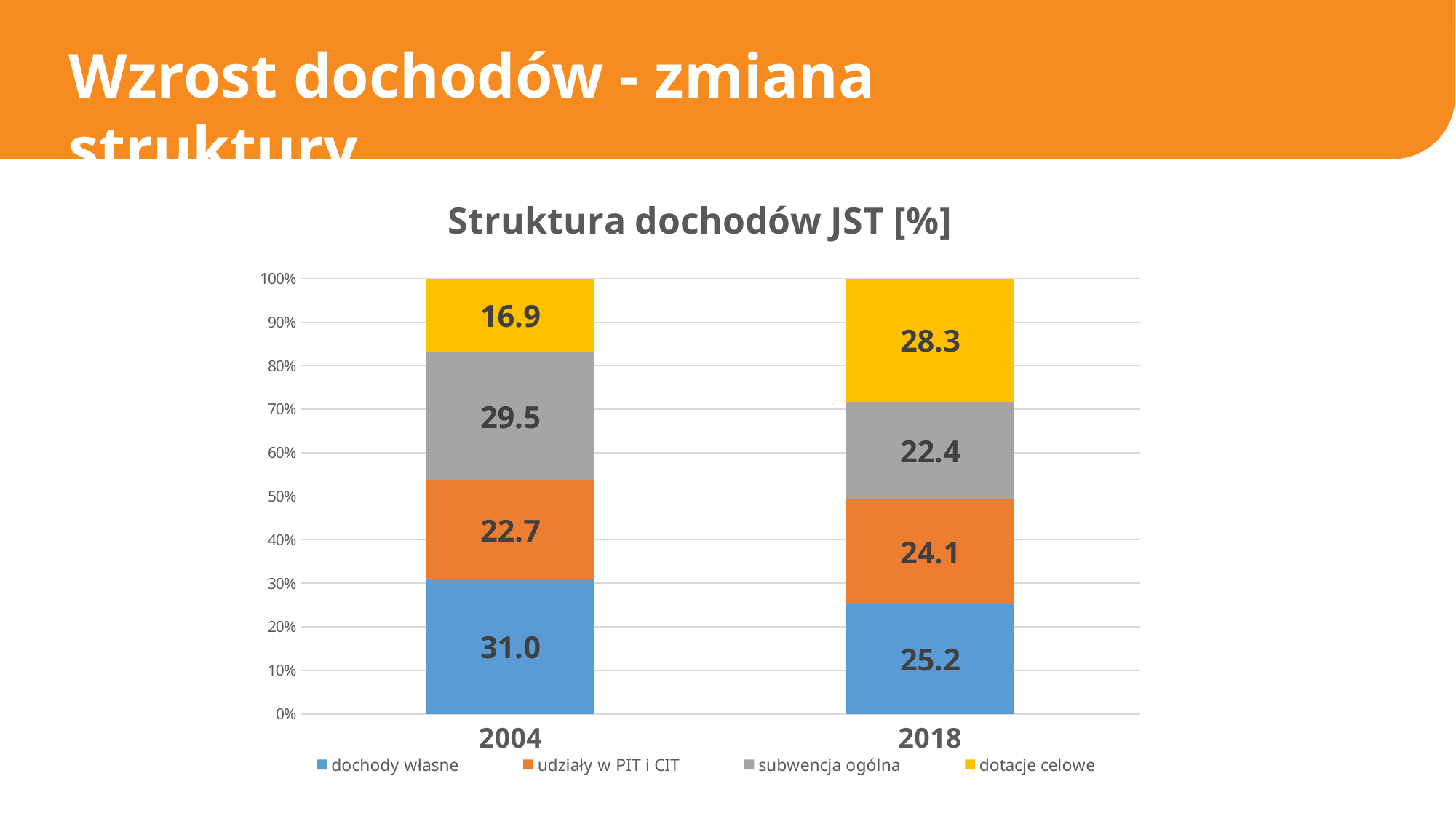
Which series has the lowest value in 2018? subwencja ogólna What is the difference between the dotacje celowe values for 2018 and 2004? 11.4 What is the value for dochody własne in 2004? 31.0 Which series has the lowest value in 2004? dotacje celowe What is the value for udziały w PIT i CIT in 2004? 22.7 Which is larger: subwencja ogólna in 2004 or subwencja ogólna in 2018? 2004 Which series has the highest value in 2004? dochody własne What kind of chart is shown on the slide? stacked bar chart What is the value for dotacje celowe in 2018? 28.3 What is the value for subwencja ogólna in 2018? 22.4 How many categories are shown on the x axis? 2 How many series does the legend list? 4